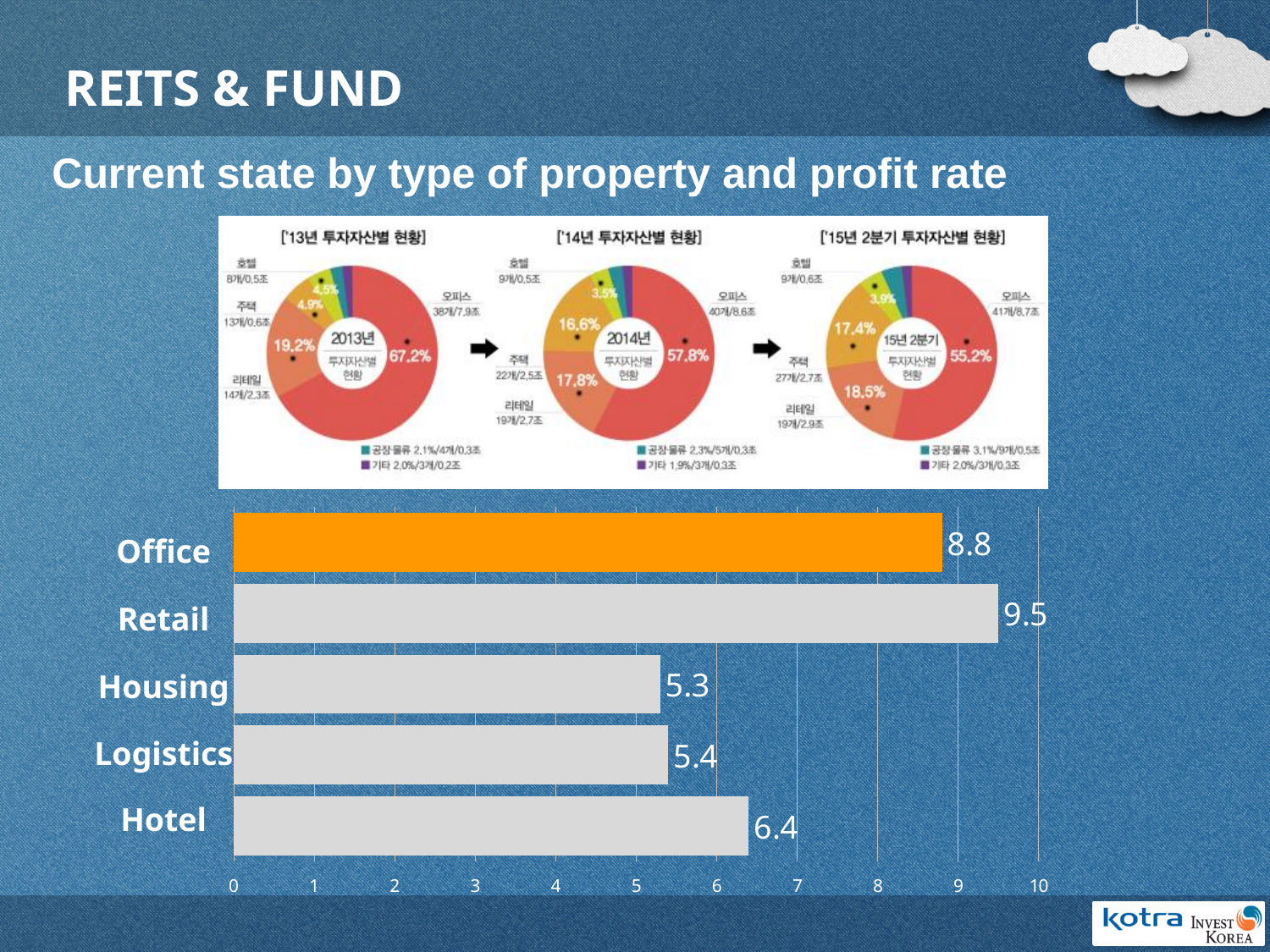
In the bar chart, which is larger, the value for Logistics or the value for Housing? Logistics In the bar chart, which category has the lowest value? Housing Across the three donut charts from 2013 to 2015 Q2, does the largest slice's percentage rise or fall? Fall What kind of chart is the lower chart on the slide? Bar chart In the bar chart, which category's bar is coloured orange? Office In the bar chart, what is the difference between the Retail and Office values? 0.7 In the bar chart, what is the value for Retail? 9.5 In the bar chart, which category has the highest value? Retail In the leftmost donut chart (2013), what percentage is shown for the largest slice? 67.2% In the bar chart, what is the value for Hotel? 6.4 How many categories are shown in the bar chart? 5 In the bar chart, what is the value for Office? 8.8